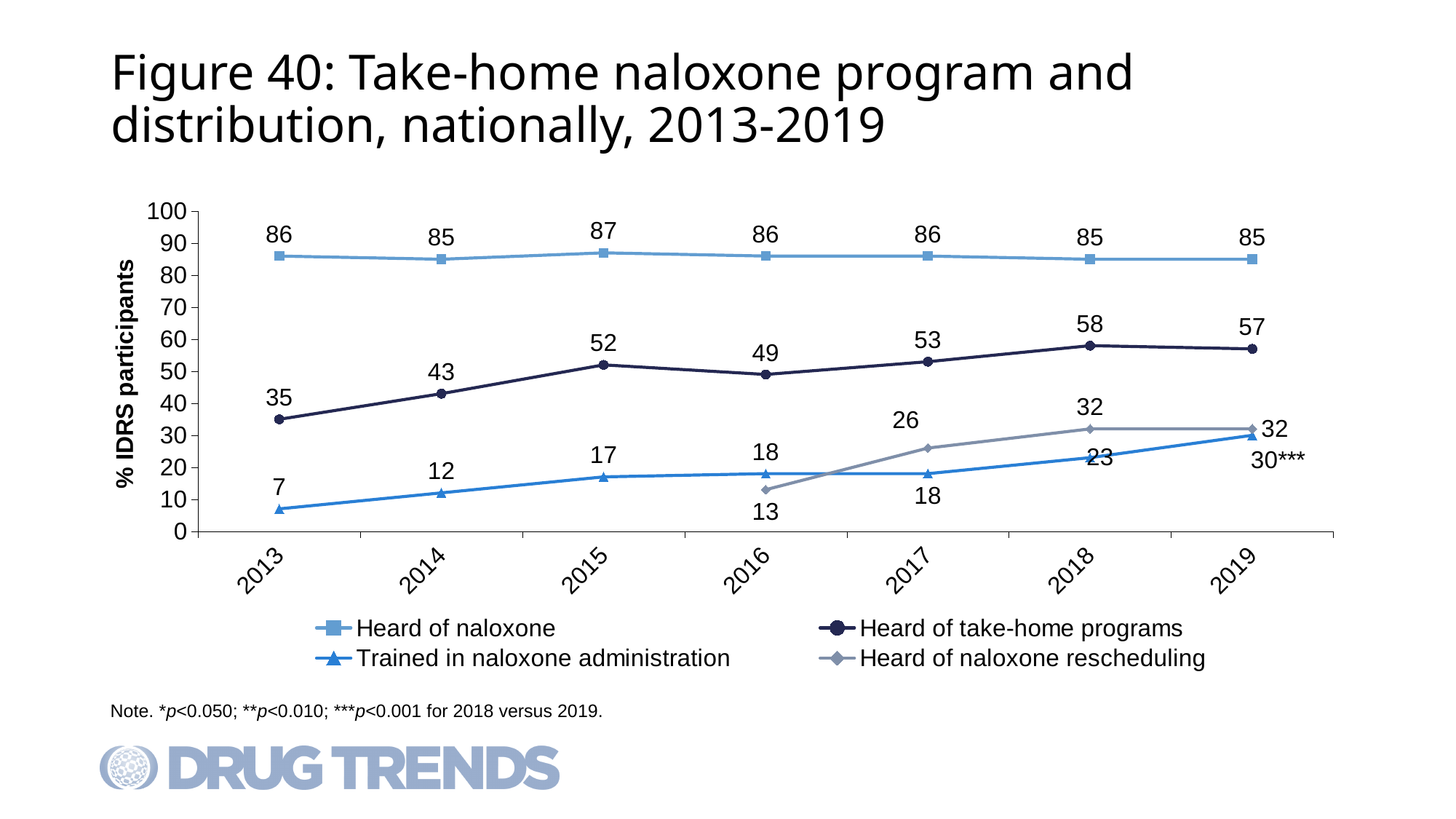
In which year was 'Heard of take-home programs' at its highest? 2018 In which year was 'Trained in naloxone administration' at its lowest? 2013 What kind of chart is shown on the slide? Line chart What is the value for 'Trained in naloxone administration' in 2018? 23 What is the value for 'Heard of naloxone rescheduling' in 2017? 26 Did 'Heard of take-home programs' rise or fall from 2013 to 2015? Rise How many years are shown on the x axis? 7 Which year had a higher value for 'Heard of take-home programs', 2016 or 2017? 2017 What percentage of IDRS participants had heard of take-home programs in 2015? 52 By how many percentage points did 'Heard of take-home programs' increase from 2013 to 2018? 23 How many series does the legend list? 4 What is the value for 'Heard of naloxone' in 2019? 85